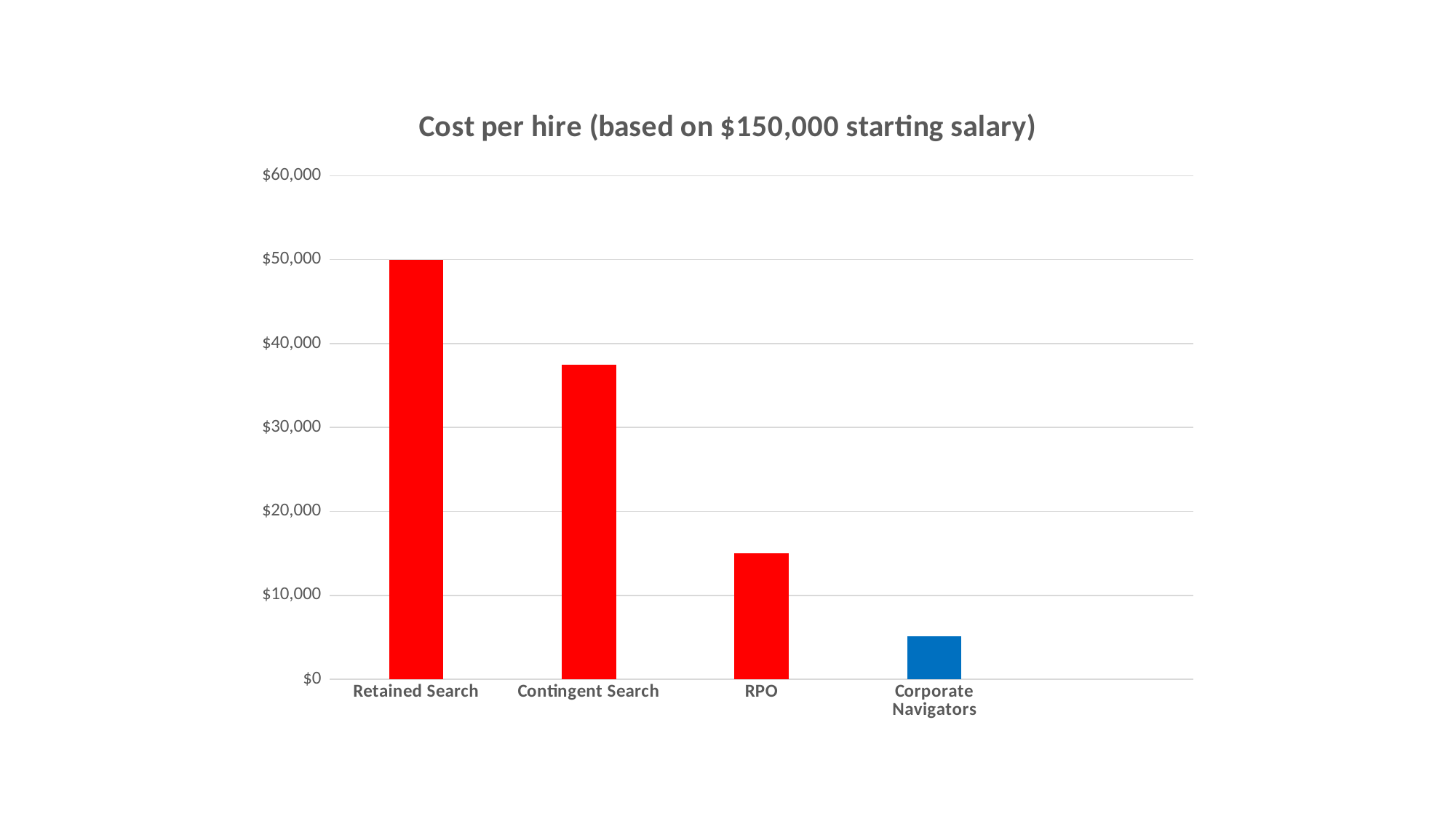
What is the cost per hire for Retained Search? $50,000 What kind of chart is shown on the slide? bar chart Is the value for Contingent Search greater or less than $40,000? less Is the value for Contingent Search greater or less than $30,000? greater Is the value for Corporate Navigators greater or less than $10,000? less Do the values rise or fall from left to right along the x axis? fall What is the title of the chart? Cost per hire (based on $150,000 starting salary) How many categories are shown on the x axis? 4 Which is larger, the value for Contingent Search or the value for RPO? Contingent Search Which category has the lowest cost per hire? Corporate Navigators Which category has the highest cost per hire? Retained Search